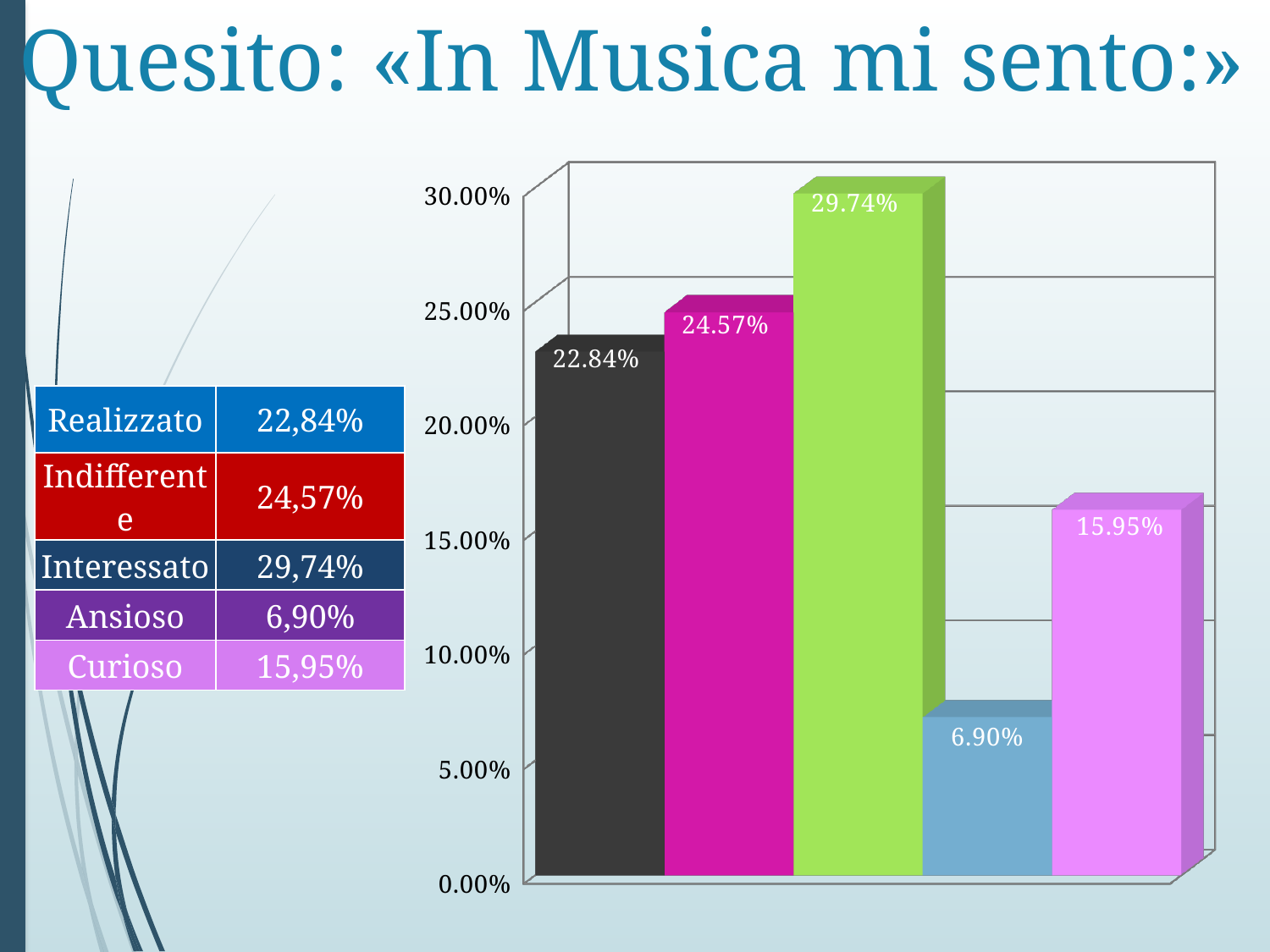
What is the value labelled on the last (light purple) bar of the chart? 15.95% What value does the table give for Curioso? 15,95% According to the table, which category has the lowest value? Ansioso What is the difference between the value labelled on the green bar (29.74%) and the value labelled on the blue bar (6.90%)? 22.84% Which is larger, the value for Realizzato or the value for Indifferente? Indifferente What kind of chart is shown on the slide? bar chart According to the table, which category has the highest value? Interessato What is the value labelled on the first (dark grey) bar of the chart? 22.84% What value is labelled on the tallest bar in the chart? 29.74% What value is labelled on the shortest bar in the chart? 6.90% Is the value labelled on the magenta bar greater or less than 25.00%? less How many bars are plotted in the chart? 5